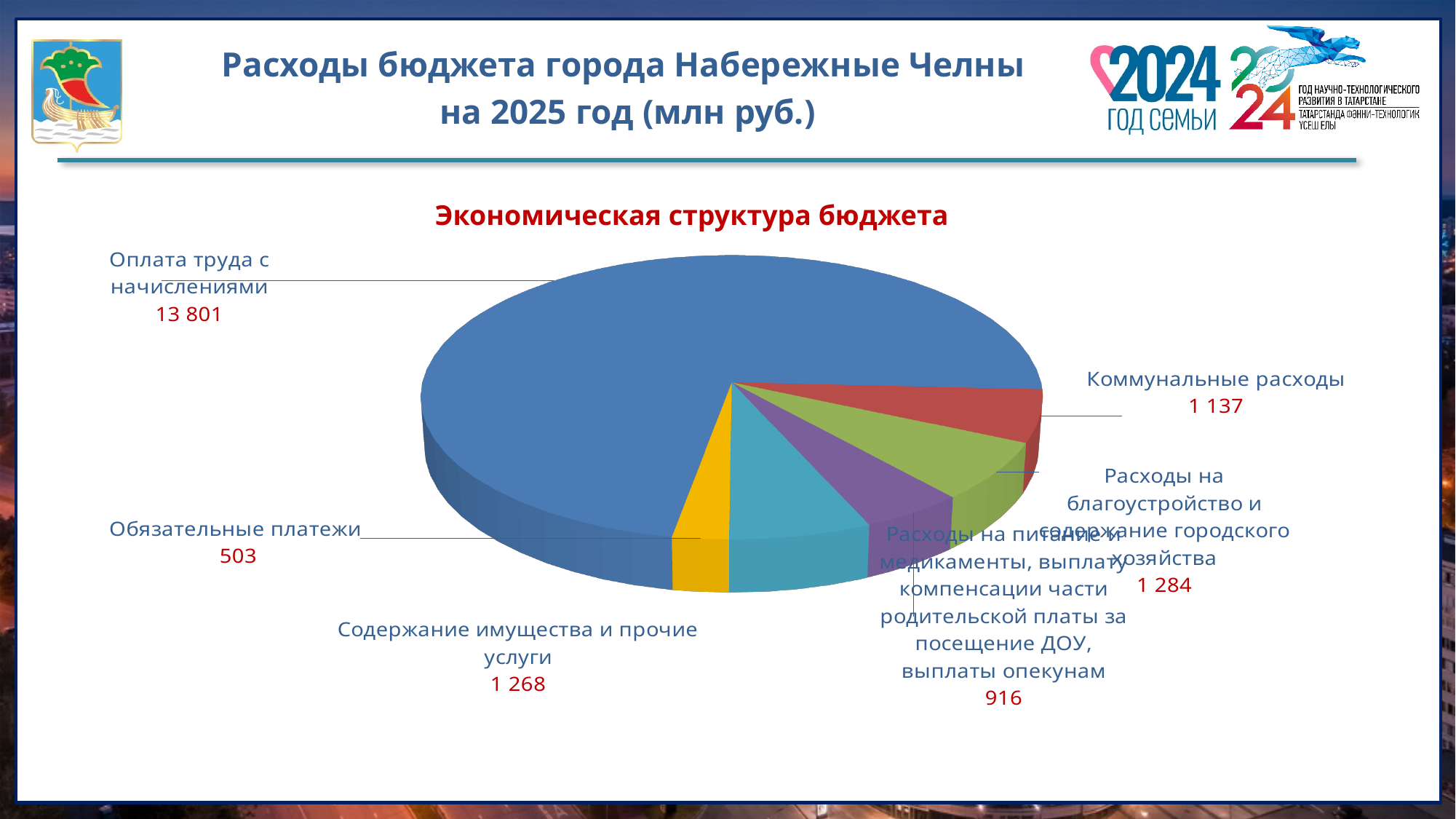
What type of chart is shown on the slide? Pie chart What is the value for "Обязательные платежи"? 503 How many categories (slices) does the pie chart have? 6 What is the value for "Коммунальные расходы"? 1 137 What is the value for "Оплата труда с начислениями"? 13 801 What is the difference between "Оплата труда с начислениями" and "Обязательные платежи"? 13 298 Which category has the largest value in the pie chart? Оплата труда с начислениями What is the value for "Содержание имущества и прочие услуги"? 1 268 What is the title of the pie chart? Экономическая структура бюджета What is the difference between "Коммунальные расходы" and the category for food, medicines and compensation payments ("Расходы на питание и медикаменты...")? 221 Which is larger: "Расходы на благоустройство и содержание городского хозяйства" or "Содержание имущества и прочие услуги"? Расходы на благоустройство и содержание городского хозяйства Which category has the smallest value in the pie chart? Обязательные платежи